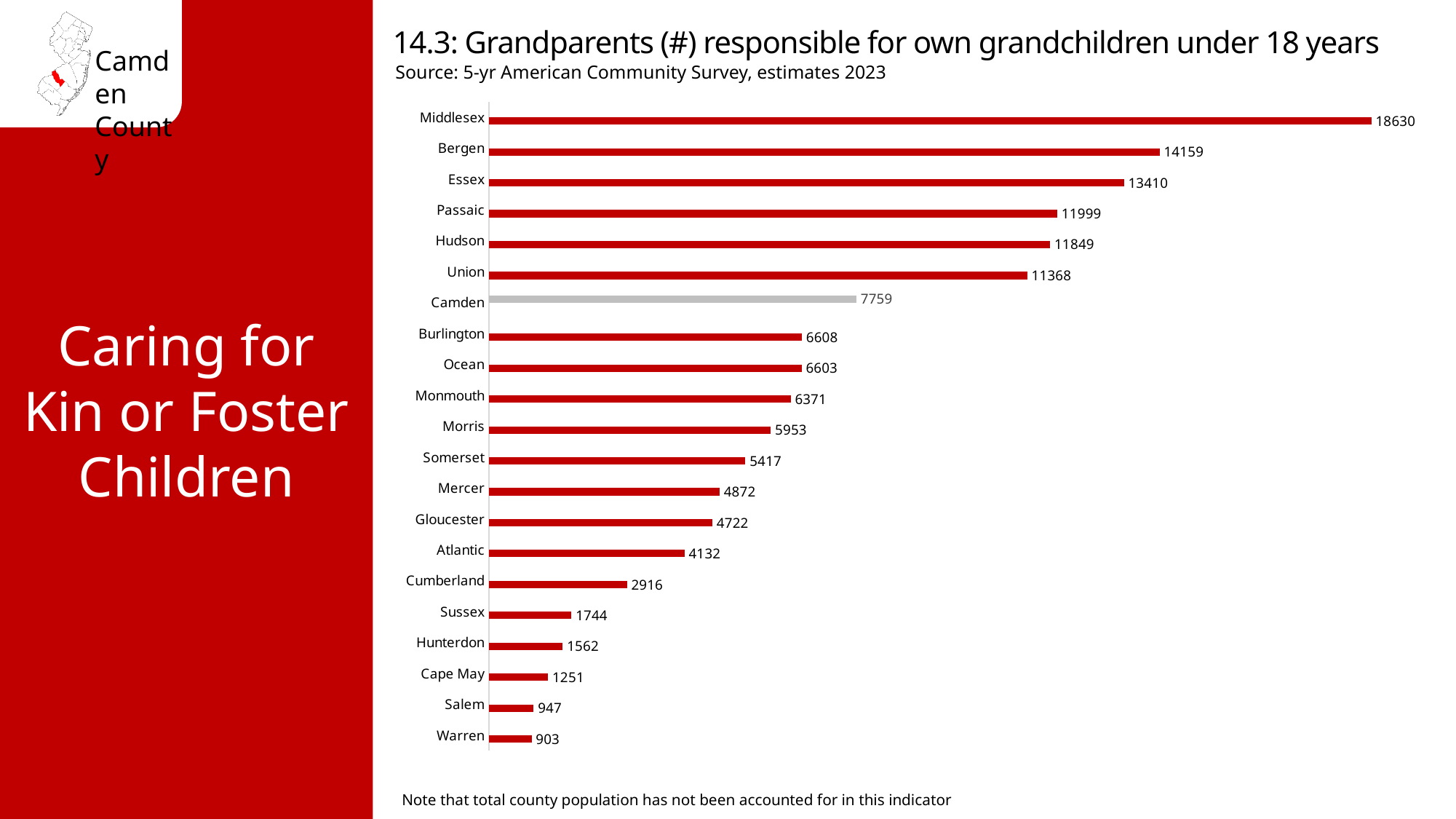
Which is larger, the value for Passaic or the value for Union? Passaic How many counties are shown in the chart? 21 What is the source of the data shown in the chart? 5-yr American Community Survey, estimates 2023 What is the difference between the values for Middlesex and Bergen? 4471 What is the difference between the values for Camden and Burlington? 1151 Which county has the highest value? Middlesex Which is larger, the value for Sussex or the value for Cumberland? Cumberland What is the value for Camden? 7759 What is the value for Gloucester? 4722 Which county has the lowest value? Warren Which county's bar is coloured grey instead of red? Camden What kind of chart is shown on the slide? Bar chart